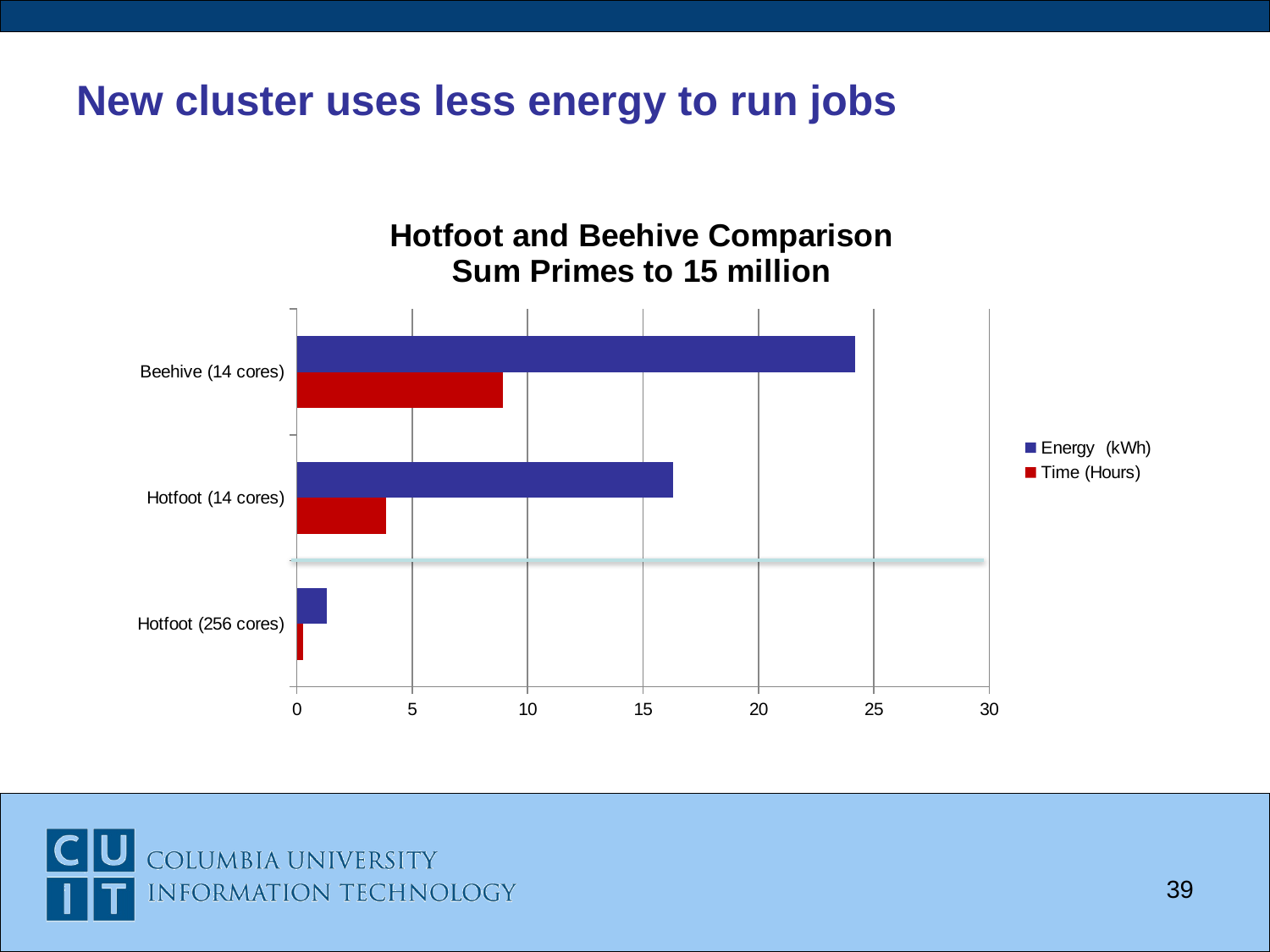
Is the Time (Hours) value for Hotfoot (14 cores) greater or less than 5? less Is the Energy (kWh) value for Beehive (14 cores) greater or less than 20? greater How many categories are shown on the chart? 3 What kind of chart is shown on the slide? bar chart Which category has the lowest Energy (kWh) value? Hotfoot (256 cores) Which category has the highest Time (Hours) value? Beehive (14 cores) Which is larger: the Energy (kWh) value for Hotfoot (14 cores) or the Energy (kWh) value for Beehive (14 cores)? Beehive (14 cores) How many series does the legend list? 2 Which category has the highest Energy (kWh) value? Beehive (14 cores) What is the title of the chart? Hotfoot and Beehive Comparison Sum Primes to 15 million Is the Energy (kWh) value for Hotfoot (14 cores) greater or less than 20? less Which category has the lowest Time (Hours) value? Hotfoot (256 cores)